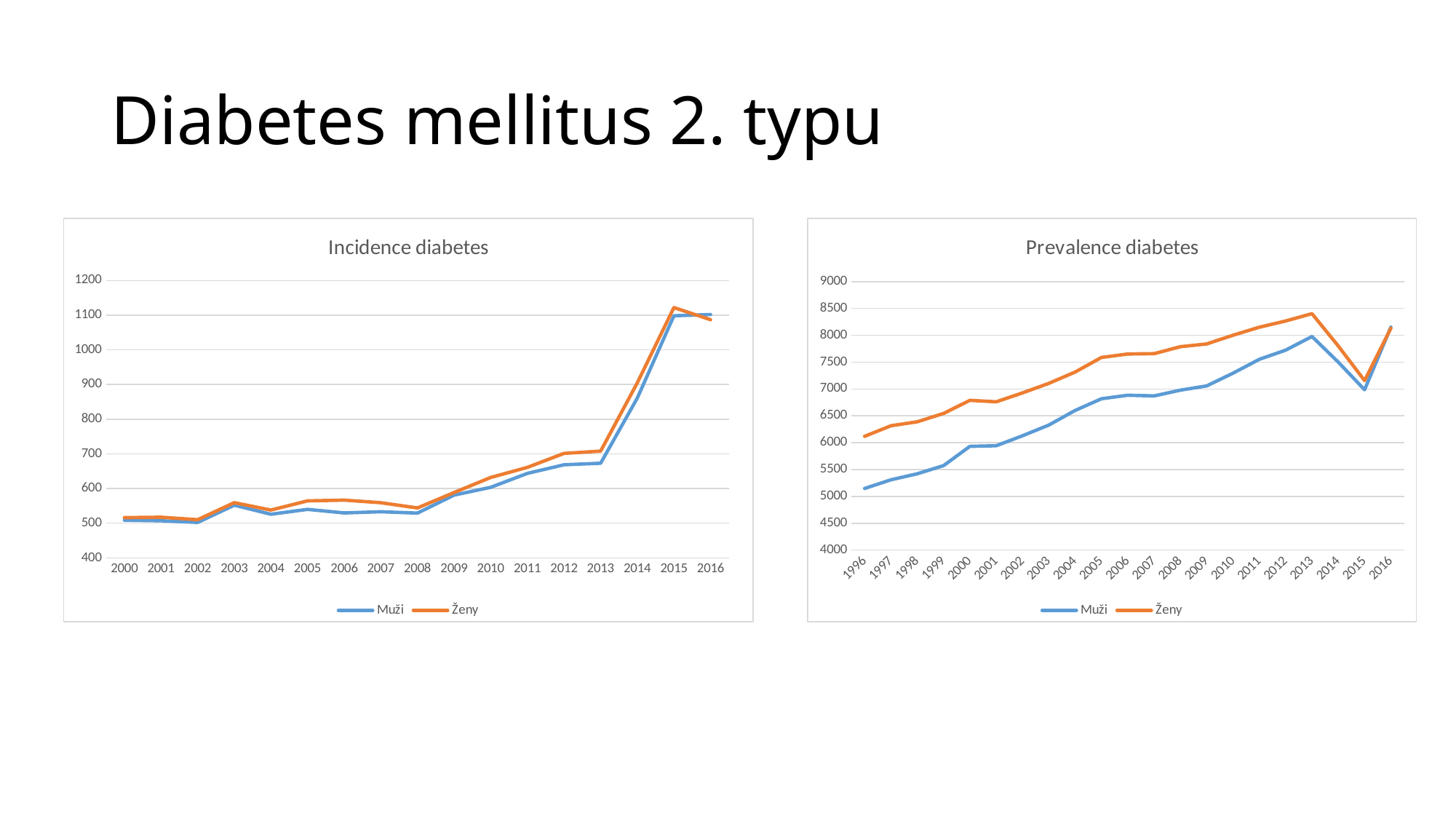
In the "Incidence diabetes" chart, is the value for Muži in 2000 greater or less than 600? less In the "Prevalence diabetes" chart, is the value for Ženy in 2013 greater or less than 8000? greater In the "Incidence diabetes" chart, is the value for Muži in 2014 greater or less than 800? greater How many years are shown on the x axis of the "Prevalence diabetes" chart? 21 In the "Prevalence diabetes" chart, which series has the larger value in 2005, Muži or Ženy? Ženy In the "Prevalence diabetes" chart, in which year does the Muži series have its lowest value? 1996 What is the title of the chart on the right side of the slide? Prevalence diabetes How many series does the legend of the "Prevalence diabetes" chart list? 2 In the "Prevalence diabetes" chart, does the Muži series rise or fall from 1996 to 2013? rise What kind of chart is the "Incidence diabetes" chart? line chart How many years are shown on the x axis of the "Incidence diabetes" chart? 17 In the "Incidence diabetes" chart, in which year does the Ženy series reach its highest value? 2015